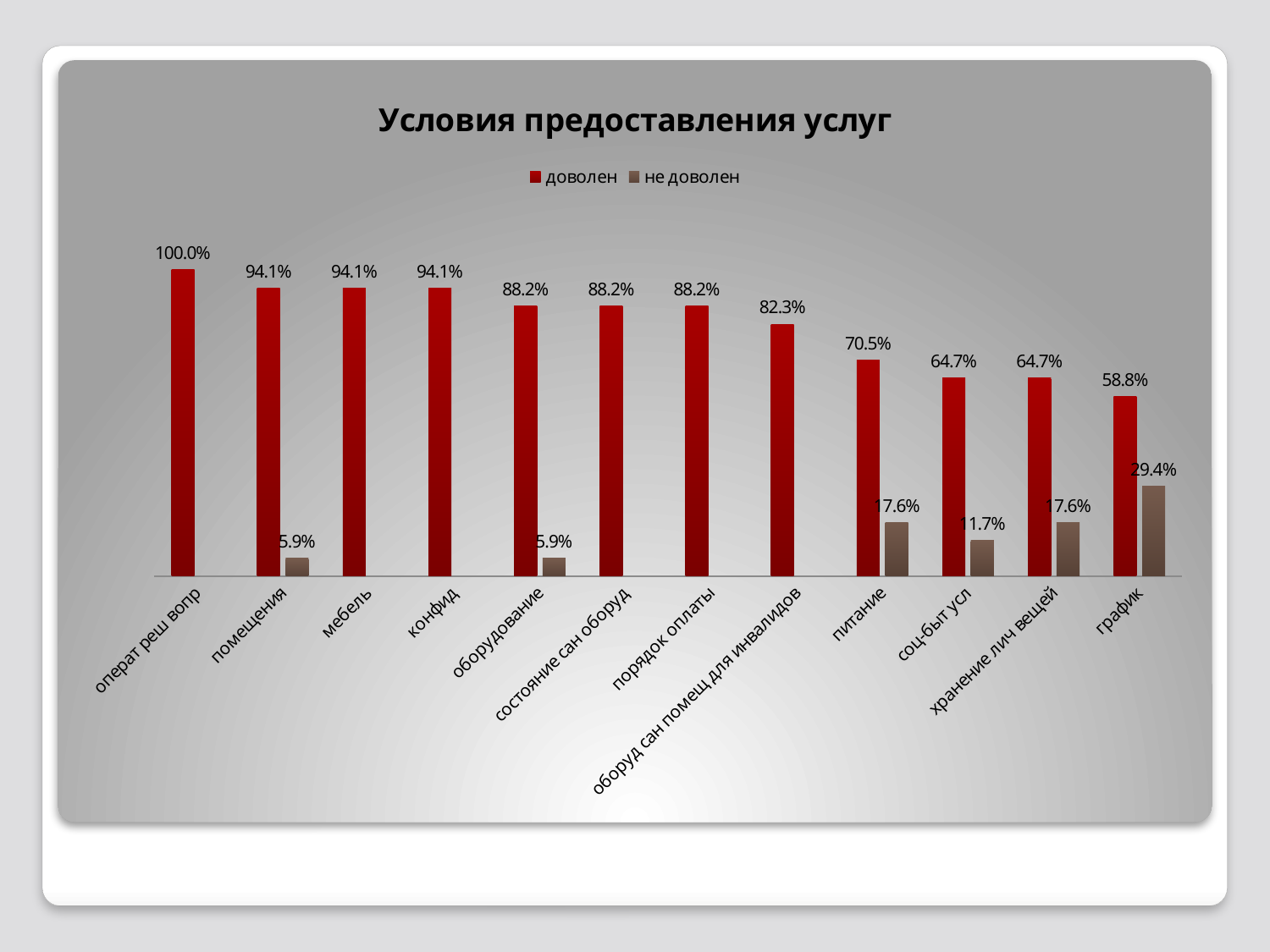
How many series does the legend list? 2 What type of chart is shown on the slide? bar chart What is the value of "доволен" for "питание"? 70.5% What is the value of "не доволен" for "график"? 29.4% What is the difference between the "доволен" values for "оборуд сан помещ для инвалидов" and "соц-быт усл"? 17.6% How many categories are shown on the x axis? 12 Which is larger: the "не доволен" value for "питание" or for "соц-быт усл"? питание Do the "доволен" values rise or fall from left to right along the x axis? fall Which category has the highest "не доволен" value? график What is the title of the chart? Условия предоставления услуг Which category has the lowest "доволен" value? график What is the value of "доволен" for "операт реш вопр"? 100.0%